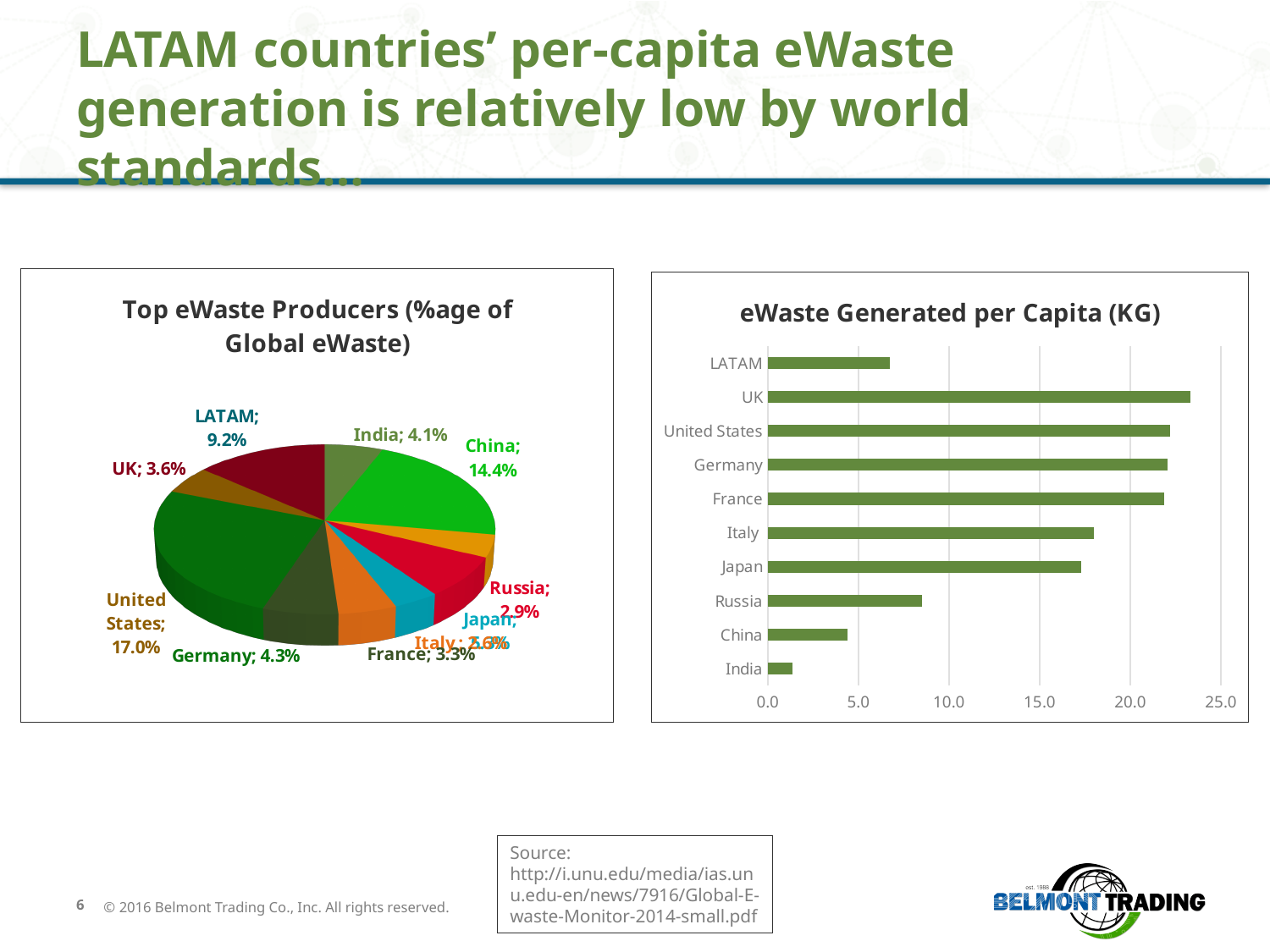
In the 'eWaste Generated per Capita (KG)' chart, is the value for LATAM greater or less than 5.0? greater In the 'Top eWaste Producers' pie chart, what is the difference between the United States' share and China's share? 2.6% How many countries/regions are shown in the 'eWaste Generated per Capita (KG)' chart? 10 In the 'Top eWaste Producers' pie chart, which has the larger share, China or LATAM? China What kind of chart is the 'eWaste Generated per Capita (KG)' chart? bar chart In the 'eWaste Generated per Capita (KG)' chart, which country has the highest value? UK In the 'eWaste Generated per Capita (KG)' chart, is the value for China greater or less than 5.0? less In the 'Top eWaste Producers' pie chart, what share of global eWaste is attributed to LATAM? 9.2% What kind of chart is the 'Top eWaste Producers (%age of Global eWaste)' chart? pie chart In the 'Top eWaste Producers' pie chart, what share of global eWaste is attributed to China? 14.4% In the 'eWaste Generated per Capita (KG)' chart, which country has the lowest value? India In the 'Top eWaste Producers' pie chart, what share of global eWaste is attributed to the United States? 17.0%